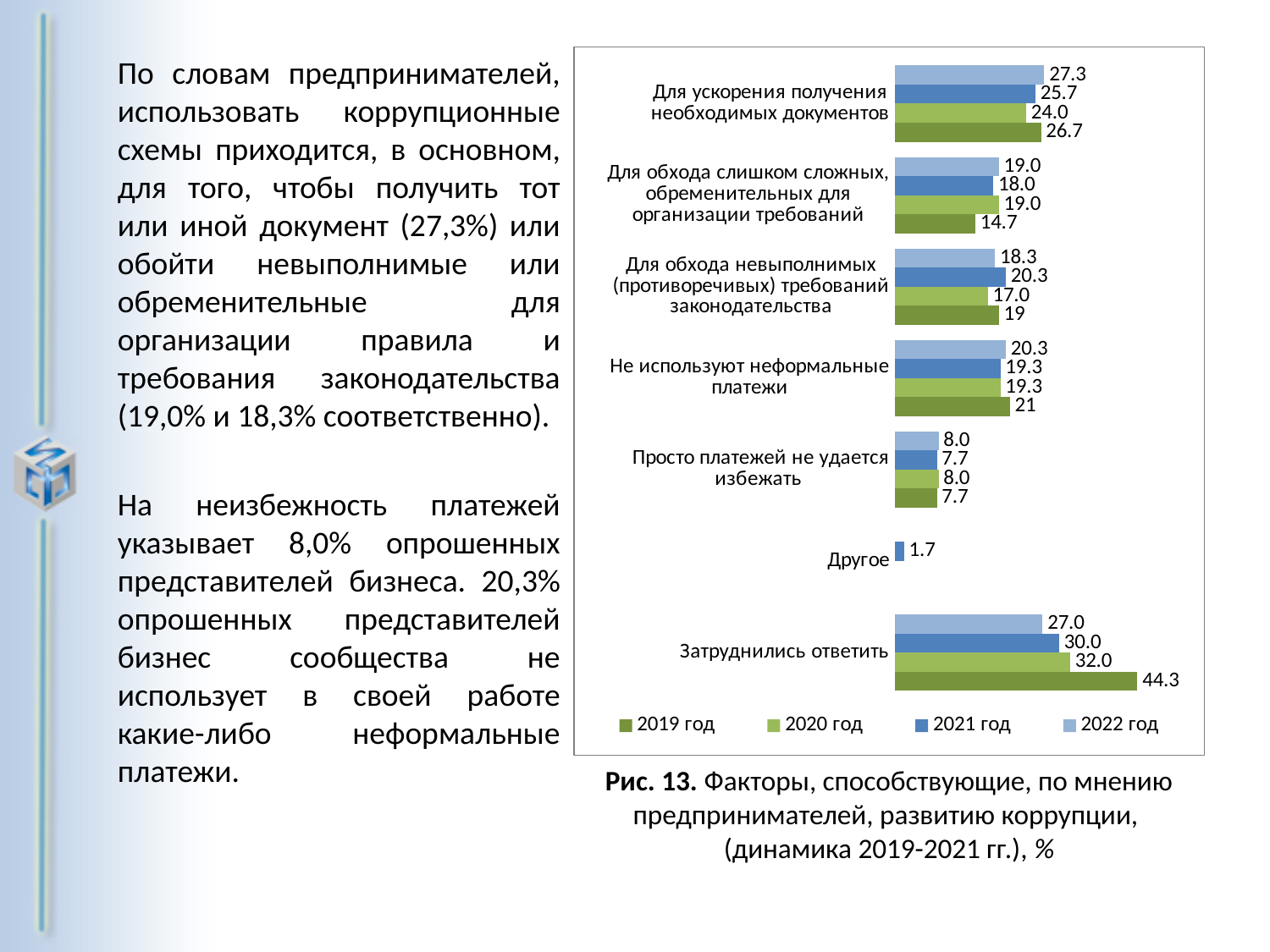
What is the difference between the 2020 год and 2022 год values for "Затруднились ответить"? 5.0 How many series does the legend list? 4 Which category has the highest 2019 год value? Затруднились ответить What is the 2019 год value for "Затруднились ответить"? 44.3 Which is larger for "Для обхода слишком сложных, обременительных для организации требований": the 2022 год value or the 2019 год value? 2022 год What is the 2022 год value for "Для ускорения получения необходимых документов"? 27.3 What kind of chart is shown on the slide? bar chart What is the 2020 год value for "Просто платежей не удается избежать"? 8.0 What is the 2021 год value for "Для обхода невыполнимых (противоречивых) требований законодательства"? 20.3 Which series is shown in dark green in the legend? 2019 год Which category has the lowest value on the chart? Другое How many categories are shown on the chart? 7